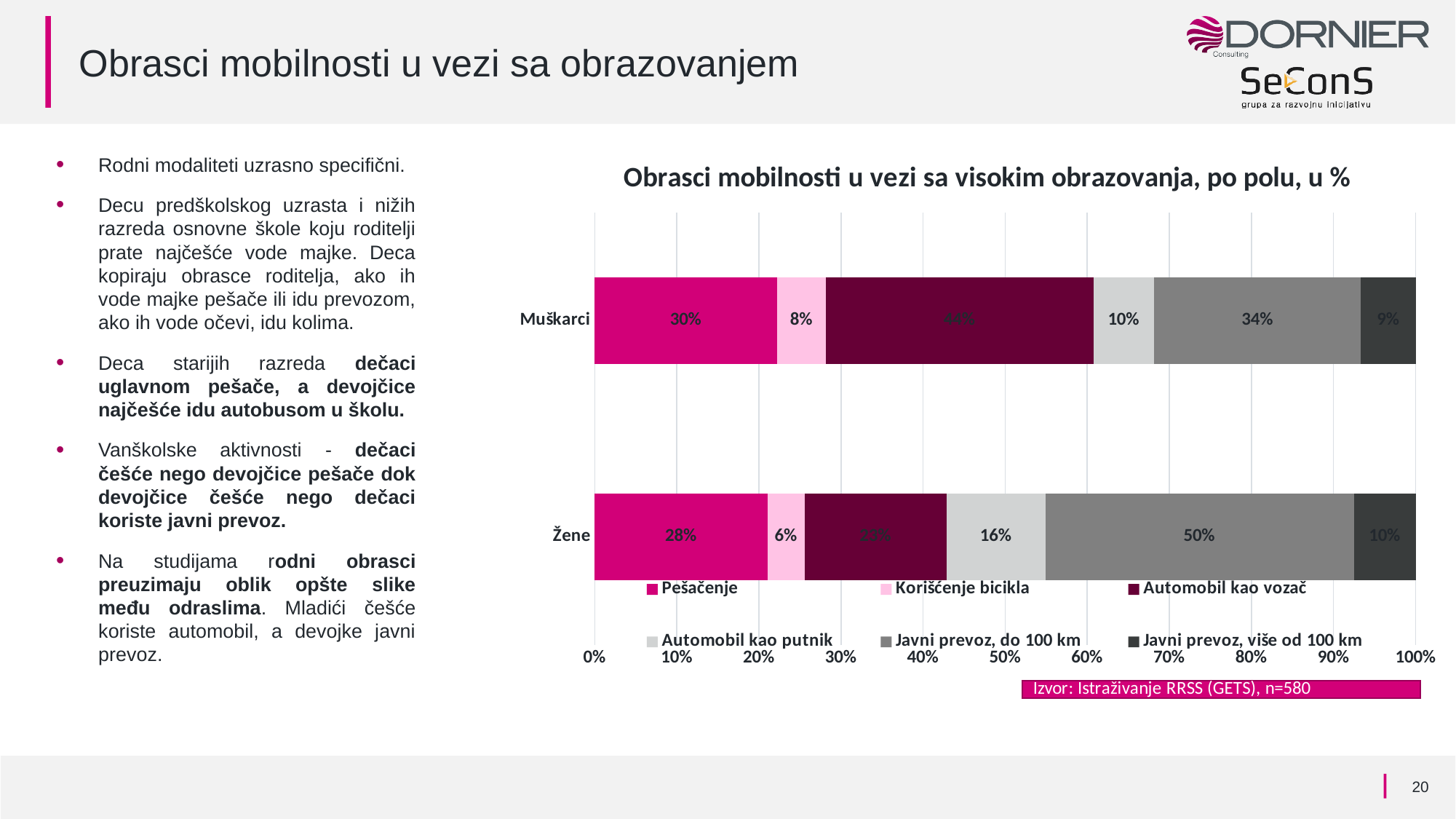
What is the value for Javni prevoz, do 100 km for Muškarci? 34% What is the value for Javni prevoz, do 100 km for Žene? 50% What is the difference between the Javni prevoz, do 100 km values for Žene and Muškarci? 16 percentage points How many series does the legend list? 6 What is the value for Pešačenje for Žene? 28% Which group has the higher value for Korišćenje bicikla, Muškarci or Žene? Muškarci What is the value for Pešačenje for Muškarci? 30% What is the value for Automobil kao putnik for Muškarci? 10% What kind of chart is shown on the slide? Stacked bar chart How many categories (bars) are shown on the chart? 2 What is the title of the chart? Obrasci mobilnosti u vezi sa visokim obrazovanja, po polu, u % What is the value for Automobil kao putnik for Žene? 16%